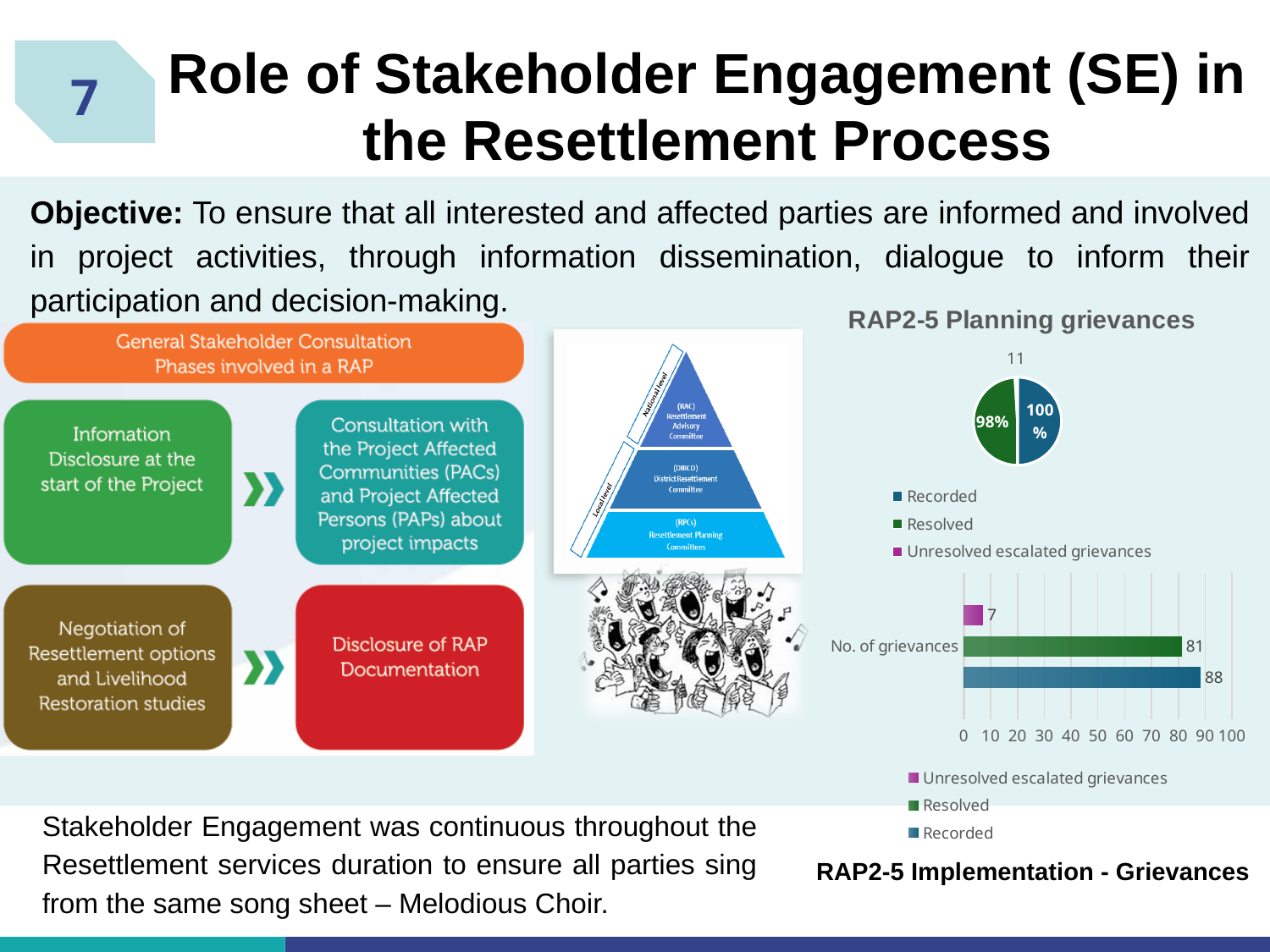
In the RAP2-5 Implementation - Grievances chart, what is the difference between Recorded and Resolved? 7 What kind of chart is the RAP2-5 Implementation - Grievances chart? bar chart In the RAP2-5 Implementation - Grievances chart, is the value for Resolved greater or less than 50? greater What is the category label on the vertical axis of the RAP2-5 Implementation - Grievances chart? No. of grievances In the RAP2-5 Implementation - Grievances chart, which series has the highest value? Recorded In the RAP2-5 Implementation - Grievances chart, what is the value for Recorded? 88 In the RAP2-5 Implementation - Grievances chart, which is larger, Resolved or Unresolved escalated grievances? Resolved What kind of chart is the RAP2-5 Planning grievances chart? pie chart In the RAP2-5 Implementation - Grievances chart, which series has the lowest value? Unresolved escalated grievances In the RAP2-5 Implementation - Grievances chart, what is the value for Resolved? 81 How many series does the legend of the RAP2-5 Implementation - Grievances chart list? 3 In the RAP2-5 Implementation - Grievances chart, what is the value for Unresolved escalated grievances? 7